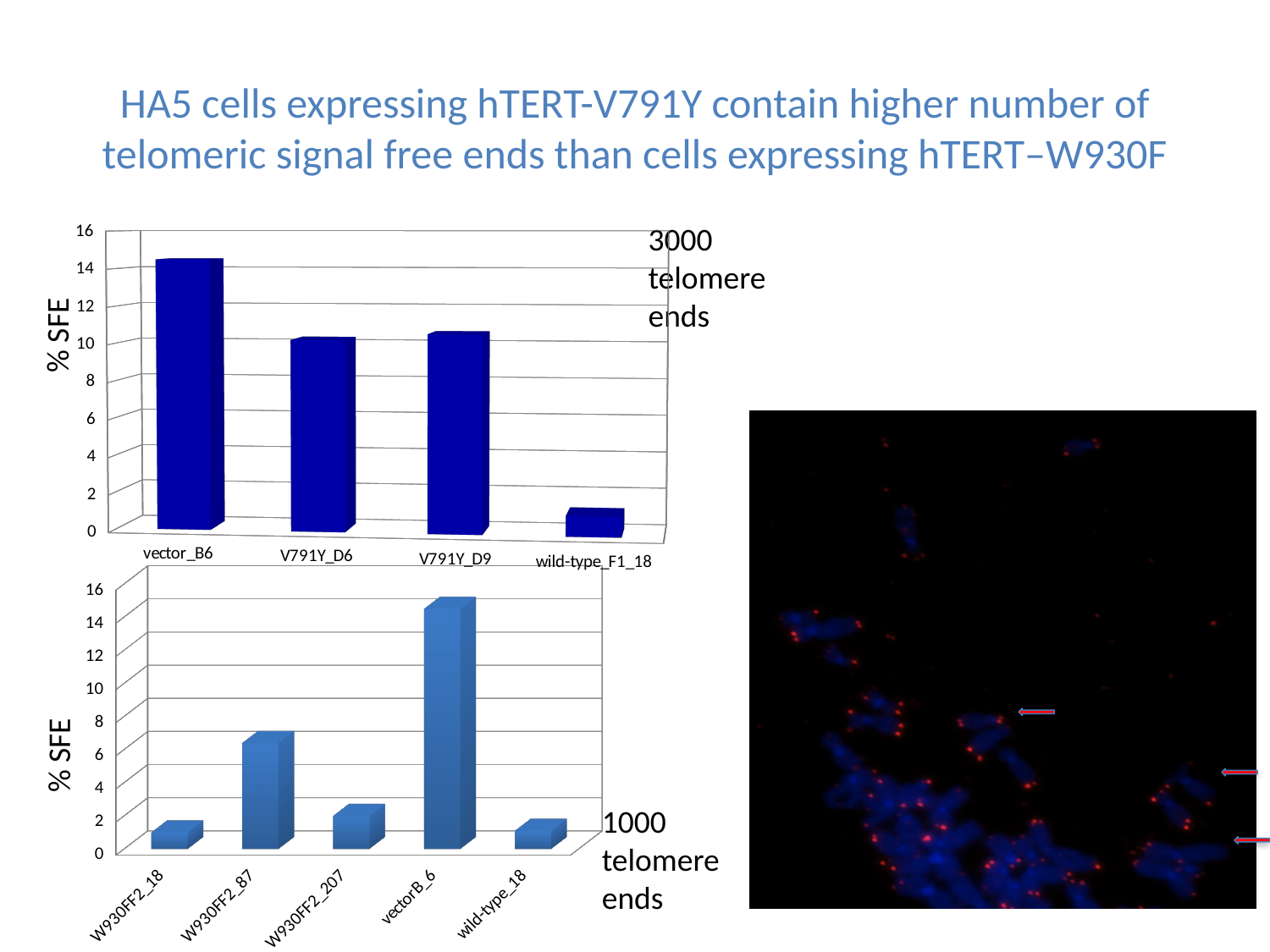
In the bottom chart, which category has the highest % SFE? vectorB_6 In the top chart, which category has the lowest % SFE? wild-type_F1_18 In the bottom chart, is the value for vectorB_6 greater or less than 12? greater What type of chart is the top chart? bar chart In the top chart, is the value for vector_B6 greater or less than 12? greater In the top chart, is the value for wild-type_F1_18 greater or less than 2? less In the top chart, which category has the highest % SFE? vector_B6 In the bottom chart, which is larger, W930FF2_87 or W930FF2_207? W930FF2_87 How many categories are shown in the top chart? 4 How many categories are shown in the bottom chart? 5